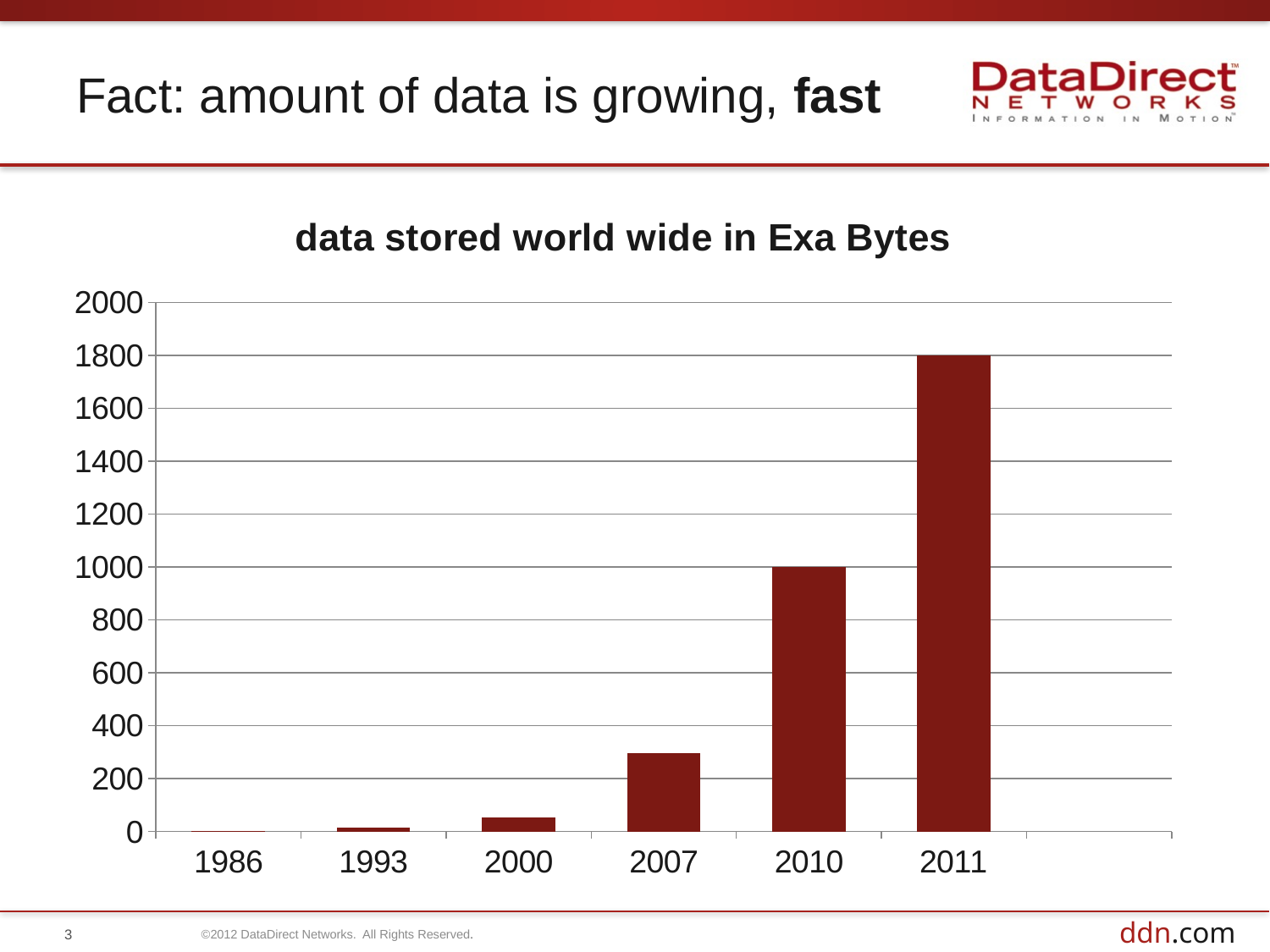
What is the value for 2010 in Exa Bytes? 1000 What is the title of the chart? data stored world wide in Exa Bytes How many years are shown on the x axis of the chart? 6 Do the values rise or fall from 1986 to 2011? rise Is the value for 2007 greater or less than 400? less Which year has the lowest amount of data stored? 1986 What kind of chart is shown on the slide? bar chart What is the difference between the values for 2011 and 2010? 800 Is the value for 2007 greater or less than 200? greater What is the value for 2011 in Exa Bytes? 1800 Which year has the highest amount of data stored? 2011 Which is larger, the value for 2010 or the value for 2007? 2010